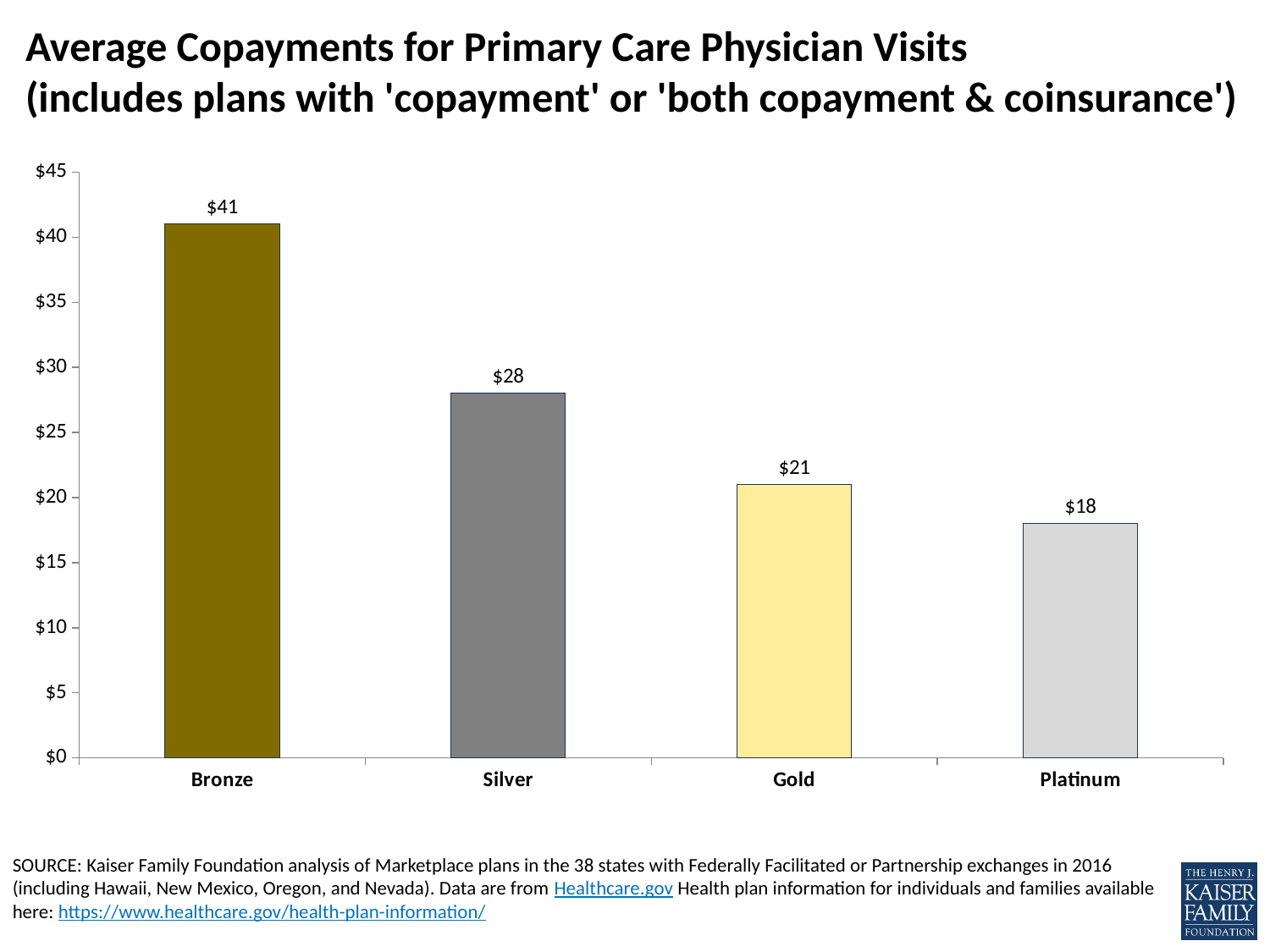
What is the average copayment for primary care physician visits for Gold plans? $21 Which plan tier has the highest average copayment for primary care physician visits? Bronze What is the average copayment for primary care physician visits for Bronze plans? $41 Which plan tier has the lowest average copayment for primary care physician visits? Platinum What is the difference between the average copayment for Bronze plans and Silver plans? $13 What is the average copayment for primary care physician visits for Silver plans? $28 Is the average copayment for Silver plans greater or less than $25? greater How many plan tiers are shown in the chart? 4 Which has a higher average copayment, Silver or Gold? Silver What is the average copayment for primary care physician visits for Platinum plans? $18 What kind of chart is shown on the slide? Bar chart What is the difference between the average copayment for Gold plans and Platinum plans? $3